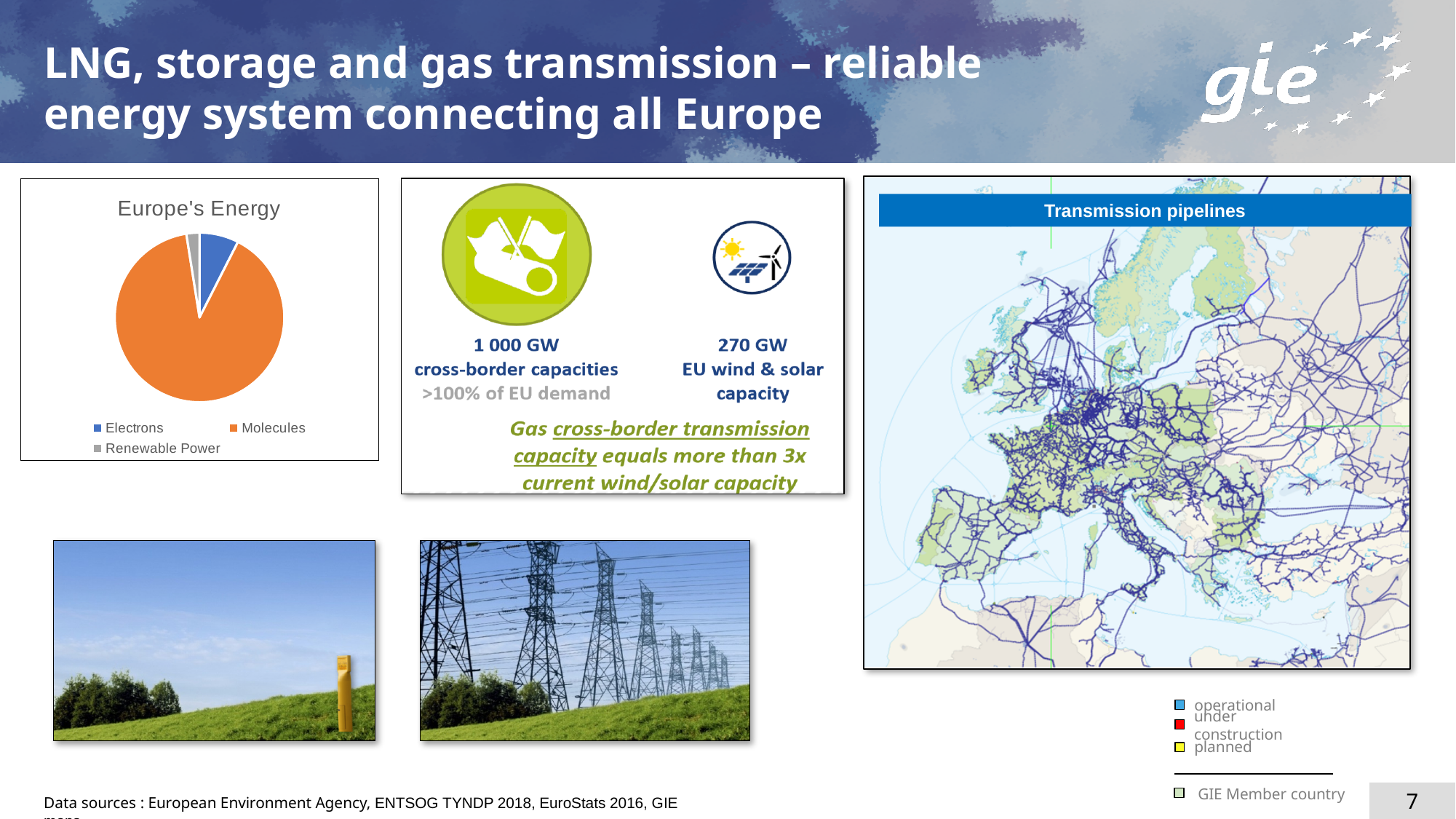
Which category has the largest slice in the "Europe's Energy" pie chart? Molecules What kind of chart is "Europe's Energy"? pie chart Which category has the smallest slice in the "Europe's Energy" pie chart? Renewable Power In the "Europe's Energy" pie chart, which slice is larger: Molecules or Electrons? Molecules What is the title of the pie chart on the left of the slide? Europe's Energy In the "Europe's Energy" pie chart, which slice is larger: Electrons or Renewable Power? Electrons How many slices does the "Europe's Energy" pie chart have? 3 How many entries does the legend of the "Europe's Energy" pie chart list? 3 What colour is the Molecules slice in the "Europe's Energy" pie chart? orange